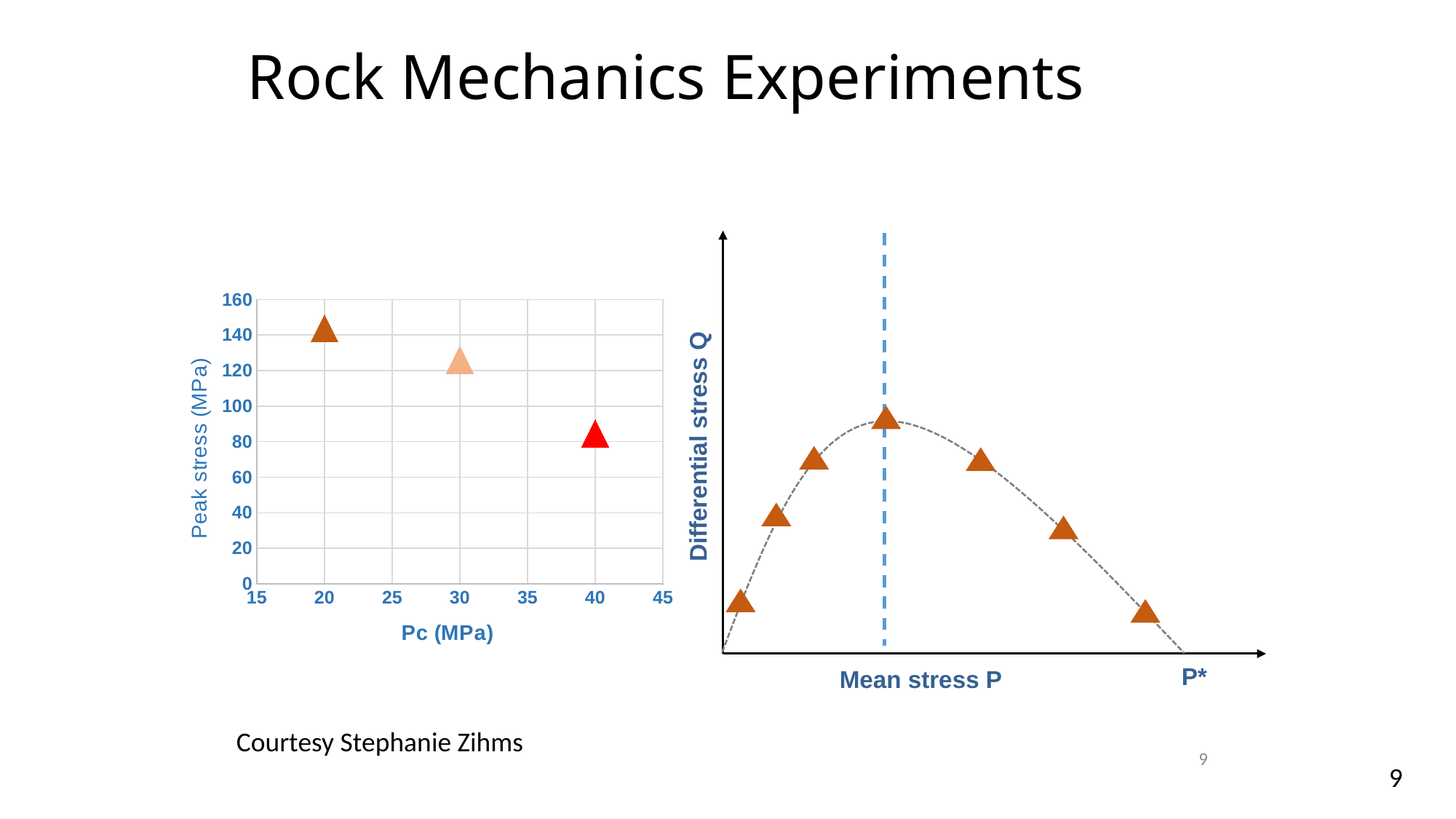
In the right chart, how many triangle data points are plotted? 7 In the left chart, how many data points are plotted? 3 In the left chart, is the peak stress at Pc = 20 MPa greater or less than 120? greater In the left chart, at which Pc value is the peak stress lowest? 40 What is the y-axis title of the left chart? Peak stress (MPa) In the left chart, at which Pc value is the peak stress highest? 20 What kind of chart is the left chart with Pc (MPa) on the x axis? scatter chart In the left chart, is the peak stress at Pc = 40 MPa greater or less than 100? less What is the x-axis title of the right chart? Mean stress P In the left chart, which has the higher peak stress: Pc = 20 MPa or Pc = 40 MPa? Pc = 20 MPa In the left chart, do the peak stress values rise or fall as Pc increases? fall In the left chart, is the peak stress at Pc = 30 MPa greater or less than 100? greater